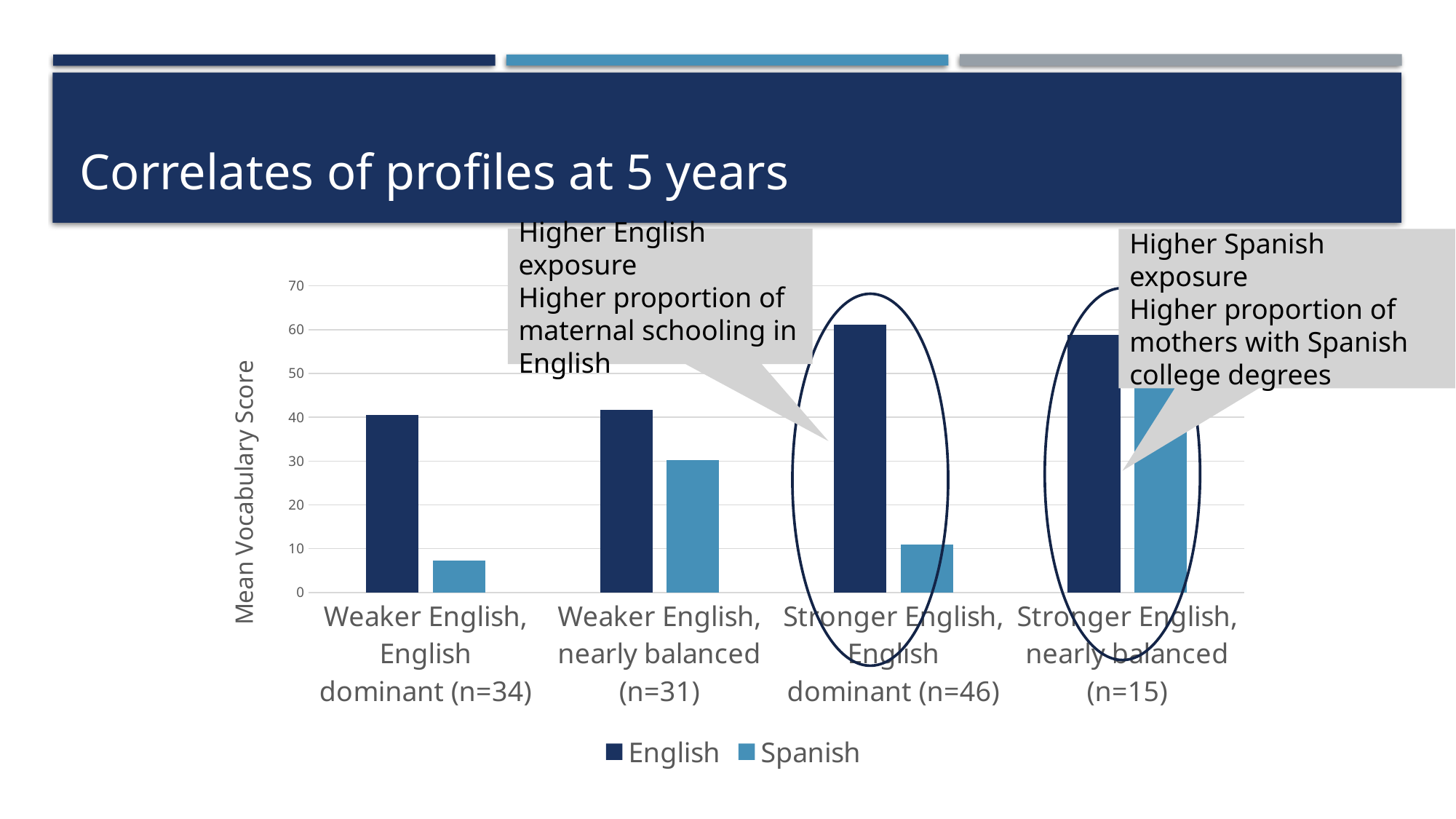
Is the Spanish score for Weaker English, English dominant (n=34) greater or less than 10? less For the Weaker English, nearly balanced (n=31) group, which is larger, the English or the Spanish score? English Is the English score for Stronger English, English dominant (n=46) greater or less than 50? greater What is the label on the vertical axis? Mean Vocabulary Score How many series does the legend list? 2 Which category has the lowest Spanish mean vocabulary score? Weaker English, English dominant (n=34) Is the Spanish score for Stronger English, English dominant (n=46) greater or less than 20? less How many profile categories are shown on the x axis? 4 Which series is shown in the lighter blue colour? Spanish What kind of chart is shown on the slide? bar chart Which category has the highest Spanish mean vocabulary score? Stronger English, nearly balanced (n=15)